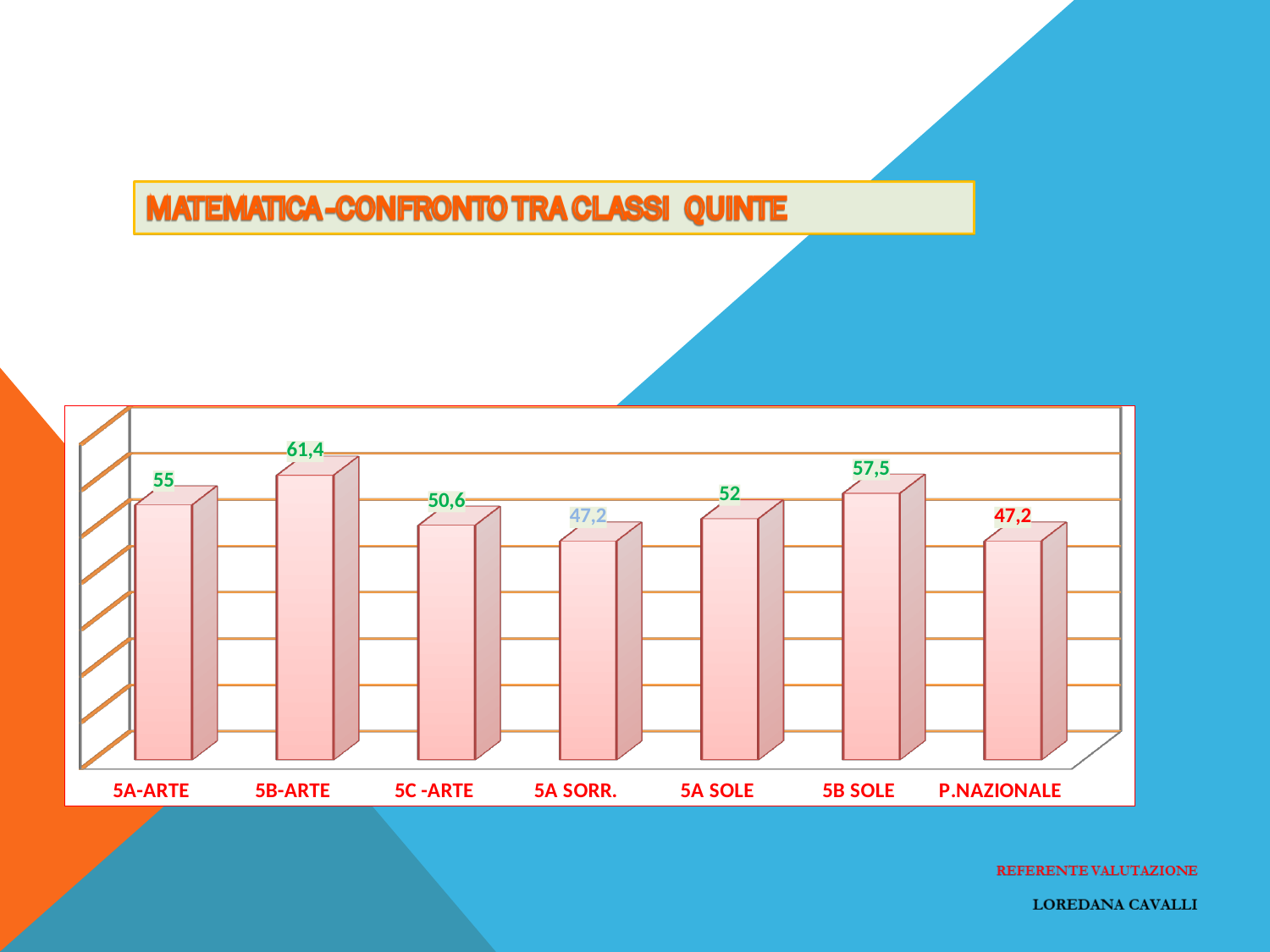
What is the difference between the values for 5B SOLE and 5A SOLE? 5,5 What is the value for P.NAZIONALE? 47,2 How many categories are shown in the chart? 7 What is the difference between the values for 5B-ARTE and 5A-ARTE? 6,4 What is the value for 5A SOLE? 52 What is the value for 5A-ARTE? 55 What kind of chart is shown on the slide? bar chart Which category has the highest value? 5B-ARTE What is the value for 5B-ARTE? 61,4 Which is larger, the value for 5B SOLE or the value for 5A SORR.? 5B SOLE What is the value for 5C -ARTE? 50,6 What is the lowest value shown in the chart? 47,2